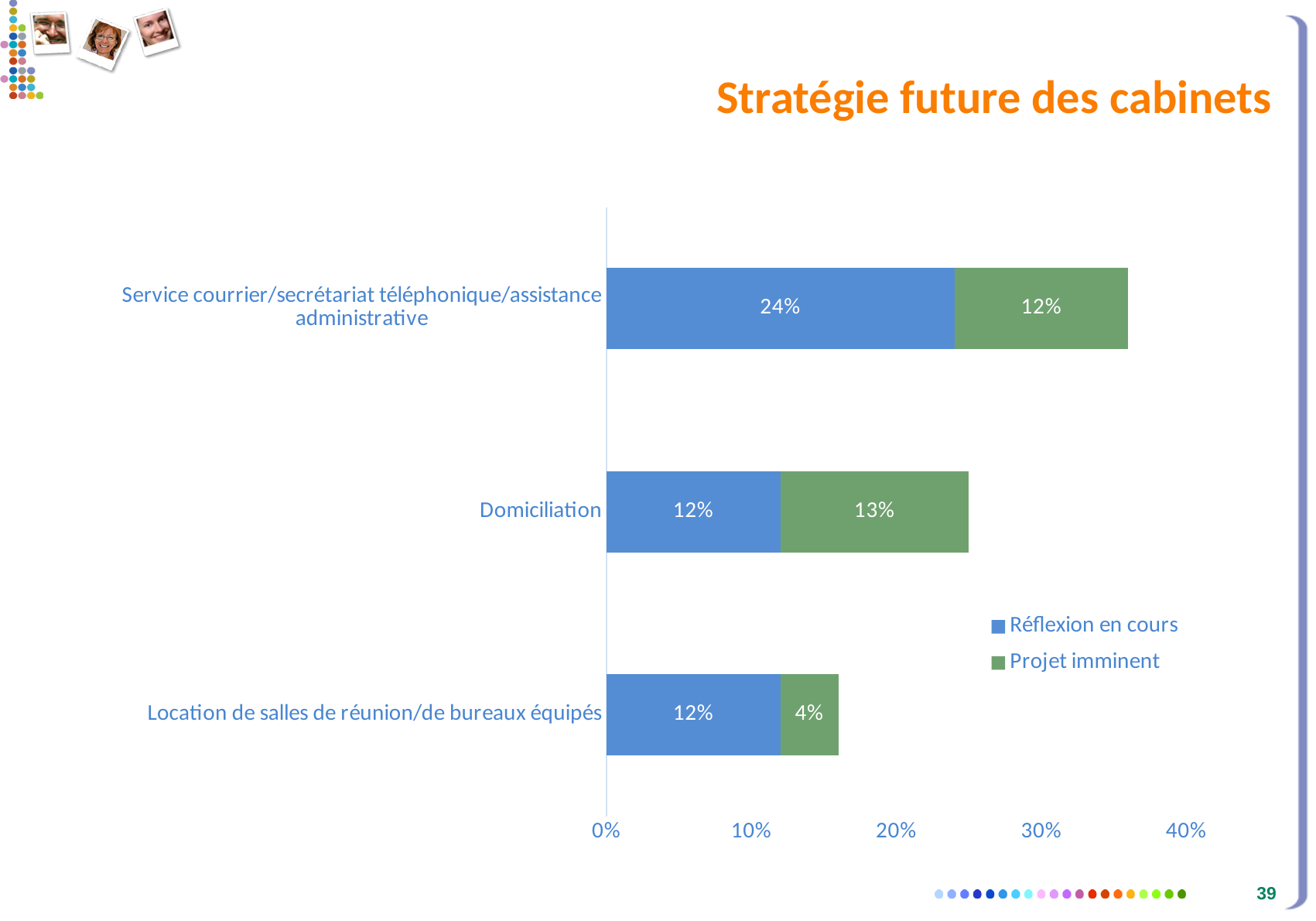
What is the 'Réflexion en cours' value for 'Service courrier/secrétariat téléphonique/assistance administrative'? 24% What is the difference between the 'Réflexion en cours' values for 'Service courrier/secrétariat téléphonique/assistance administrative' and 'Domiciliation'? 12% What is the total of the stacked bar for 'Domiciliation'? 25% What is the 'Projet imminent' value for 'Location de salles de réunion/de bureaux équipés'? 4% What kind of chart is shown on the slide? Stacked bar chart Which category has the highest 'Réflexion en cours' value? Service courrier/secrétariat téléphonique/assistance administrative How many series does the legend list? 2 How many categories are shown on the chart? 3 What is the total of the stacked bar for 'Service courrier/secrétariat téléphonique/assistance administrative'? 36% Which category has the lowest 'Projet imminent' value? Location de salles de réunion/de bureaux équipés Which is larger: the 'Projet imminent' value for 'Domiciliation' or for 'Location de salles de réunion/de bureaux équipés'? Domiciliation What is the 'Projet imminent' value for 'Domiciliation'? 13%